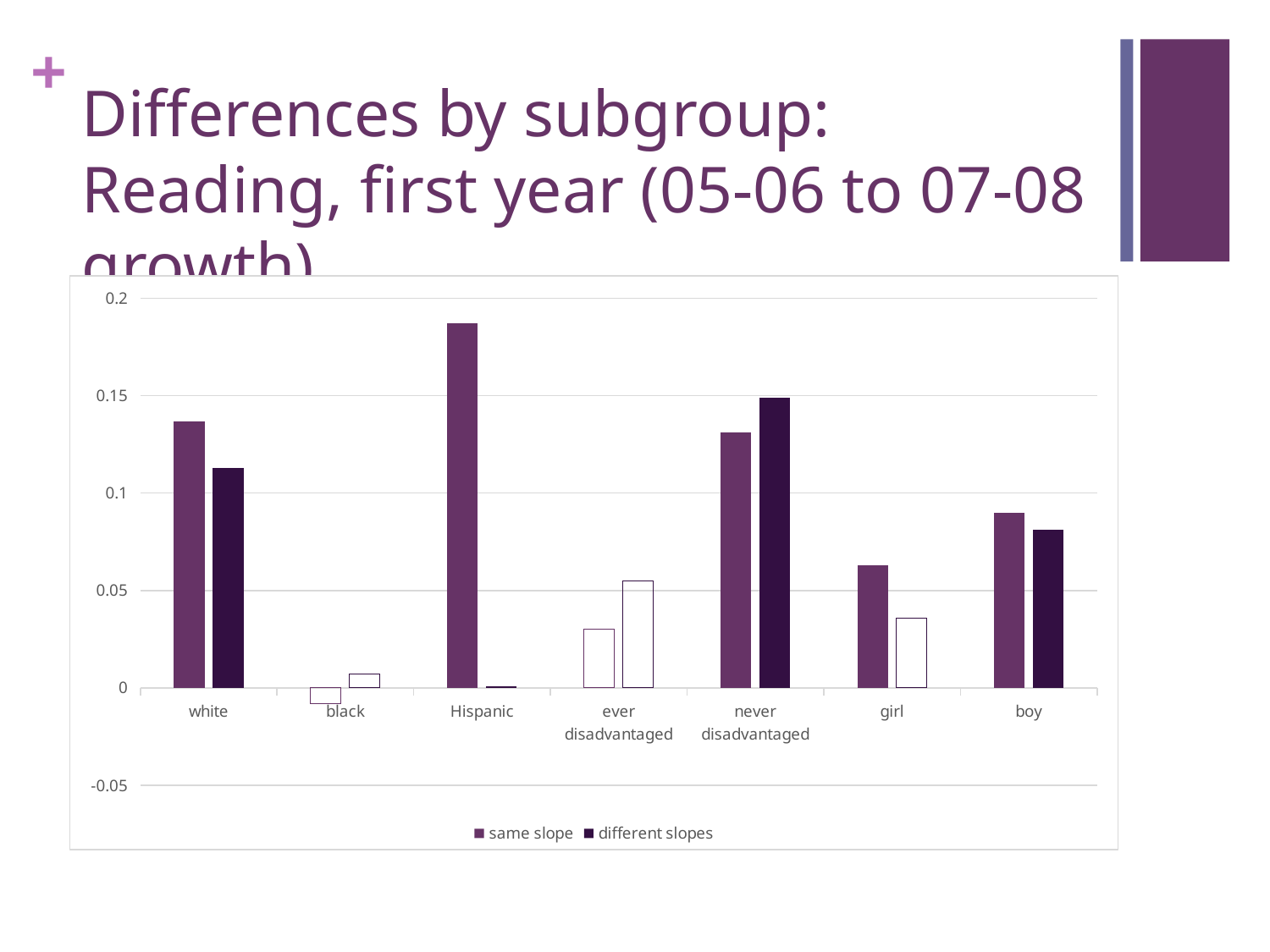
What are the two series named in the legend? same slope and different slopes Is the same slope value for Hispanic greater or less than 0.15? greater Is the different slopes value for ever disadvantaged greater or less than 0.1? less How many subgroup categories are shown on the x axis? 7 Which category has the highest value for the different slopes series? never disadvantaged How many series does the legend list? 2 What kind of chart is shown on the slide? bar chart Which category has the highest value for the same slope series? Hispanic Which category has the lowest value for the same slope series? black For white, which series has the larger value, same slope or different slopes? same slope For never disadvantaged, which series has the larger value, same slope or different slopes? different slopes Is the same slope value for white greater or less than 0.1? greater